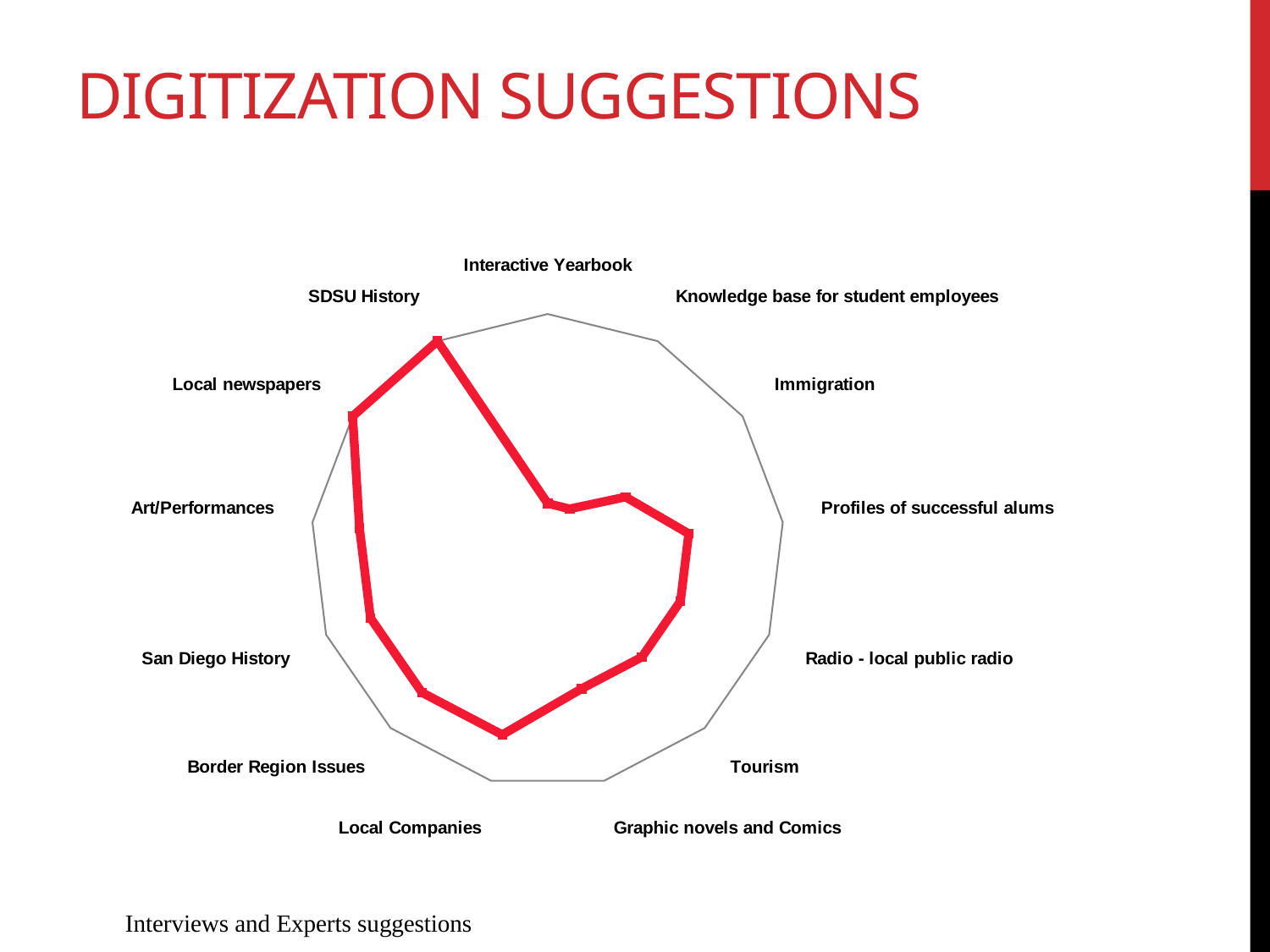
How many data series are plotted on the radar chart? 1 What colour is the data line on the radar chart? Red Which category has the lowest value on the radar chart? Interactive Yearbook and Knowledge base for student employees (tied) What is the title of the slide containing the radar chart? Digitization Suggestions Which has the larger value, Interactive Yearbook or Local Companies? Local Companies Which has the larger value, Interactive Yearbook or SDSU History? SDSU History Which has the larger value, Knowledge base for student employees or Local newspapers? Local newspapers What kind of chart is shown on the slide? Radar chart How many categories are plotted on the radar chart? 13